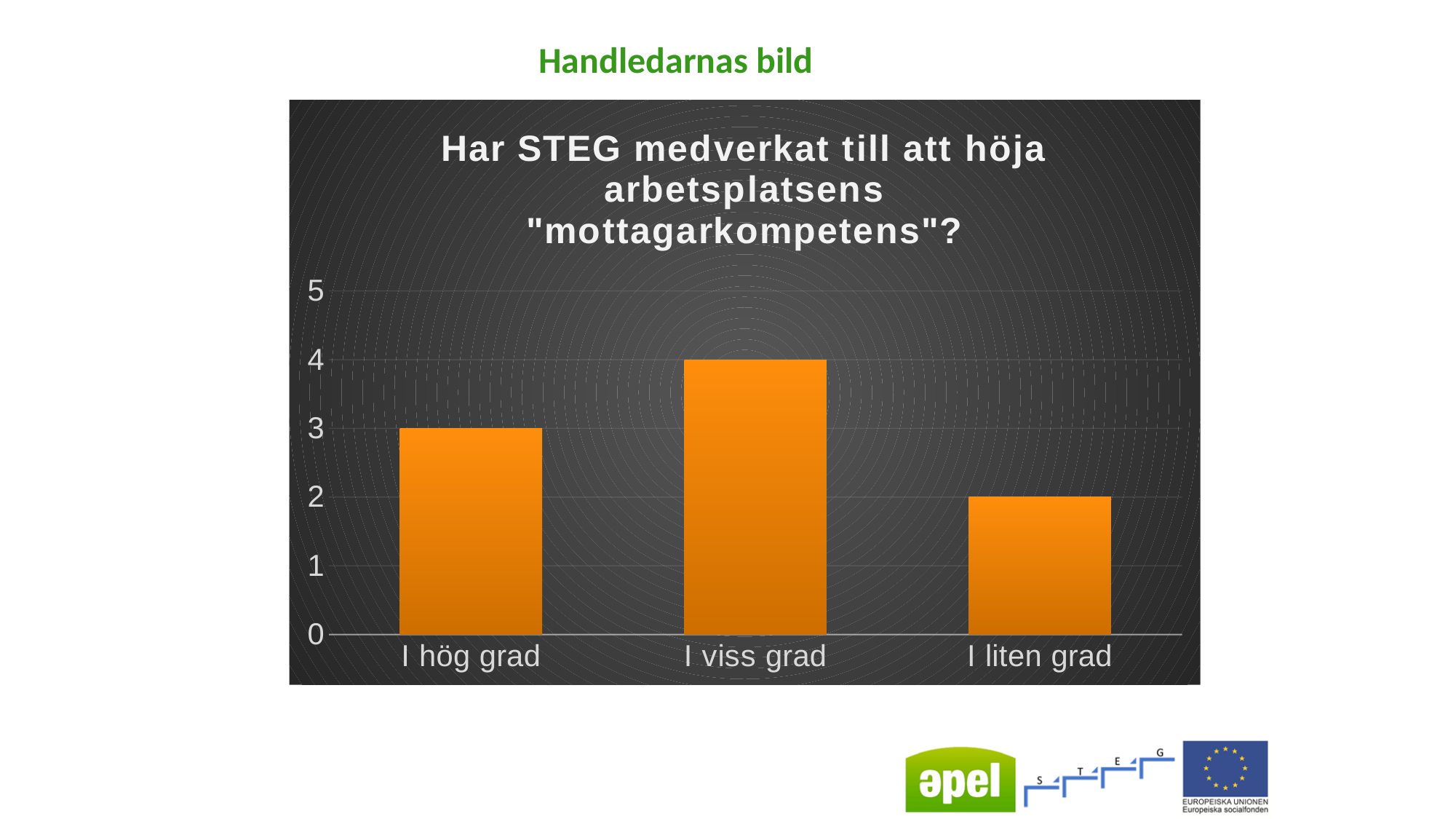
Which category has the lowest value? I liten grad What kind of chart is shown on the slide? bar chart Which category has the highest value? I viss grad What is the value for "I liten grad"? 2 What is the value for "I viss grad"? 4 What is the difference between the values for "I viss grad" and "I liten grad"? 2 What is the value for "I hög grad"? 3 Which is larger, the value for "I hög grad" or the value for "I viss grad"? I viss grad What colour are the bars in the chart? orange What is the highest value shown on the y axis of the chart? 5 How many categories are shown on the x axis of the chart? 3 What is the difference between the values for "I hög grad" and "I liten grad"? 1